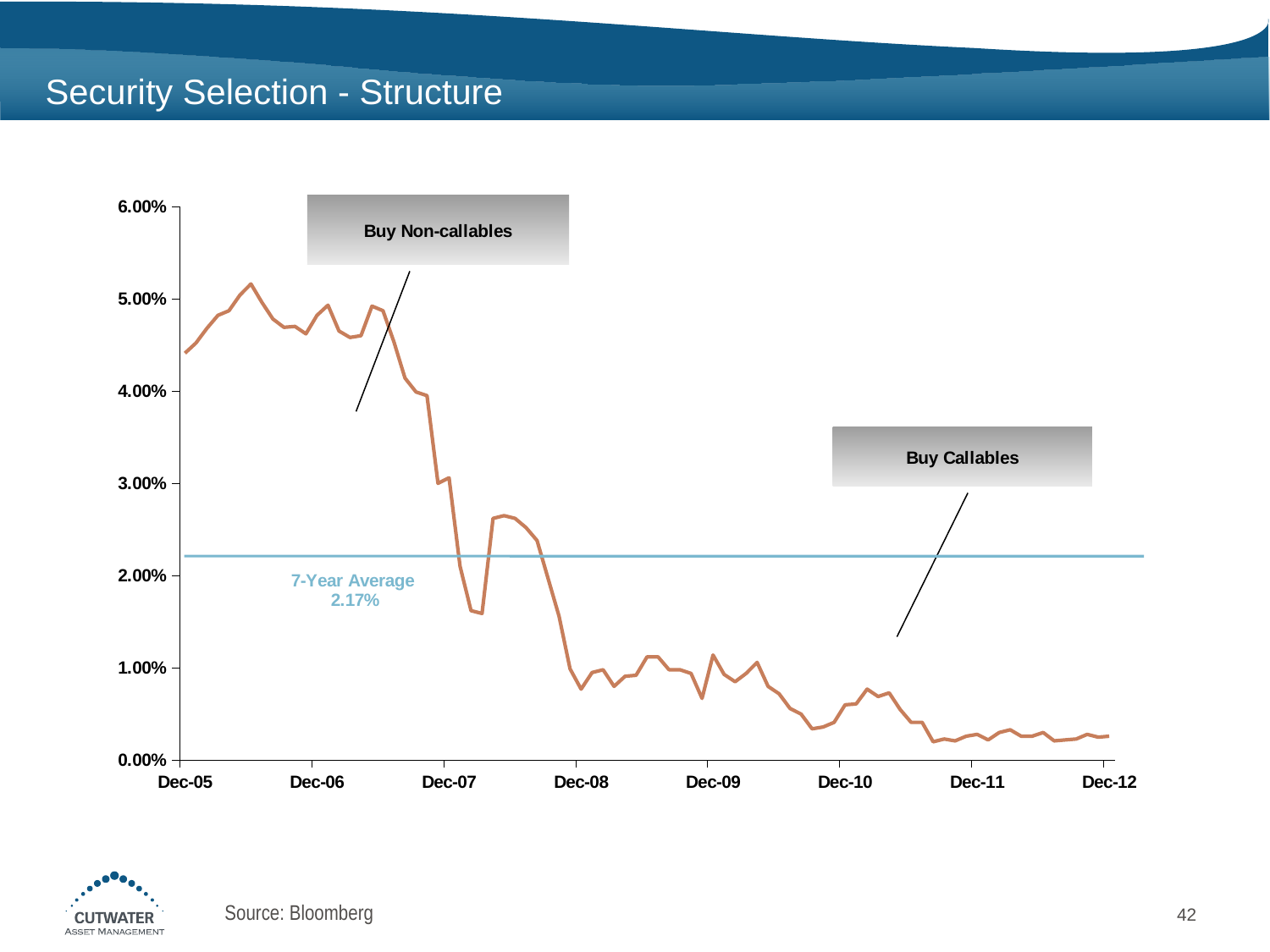
How many date labels are shown on the x axis? 8 What is the 7-Year Average value shown on the chart? 2.17% Is the value at Dec-07 greater or less than 2.00%? greater What kind of chart is shown on the slide? line chart Is the value at Dec-10 greater or less than 1.00%? less Is the value at Dec-12 greater or less than 1.00%? less Which is larger, the value at Dec-07 or the value at Dec-08? Dec-07 Which is larger, the value at Dec-05 or the value at Dec-12? Dec-05 What text is in the annotation box on the right side of the chart? Buy Callables Do the plotted values generally rise or fall from Dec-05 to Dec-12? fall